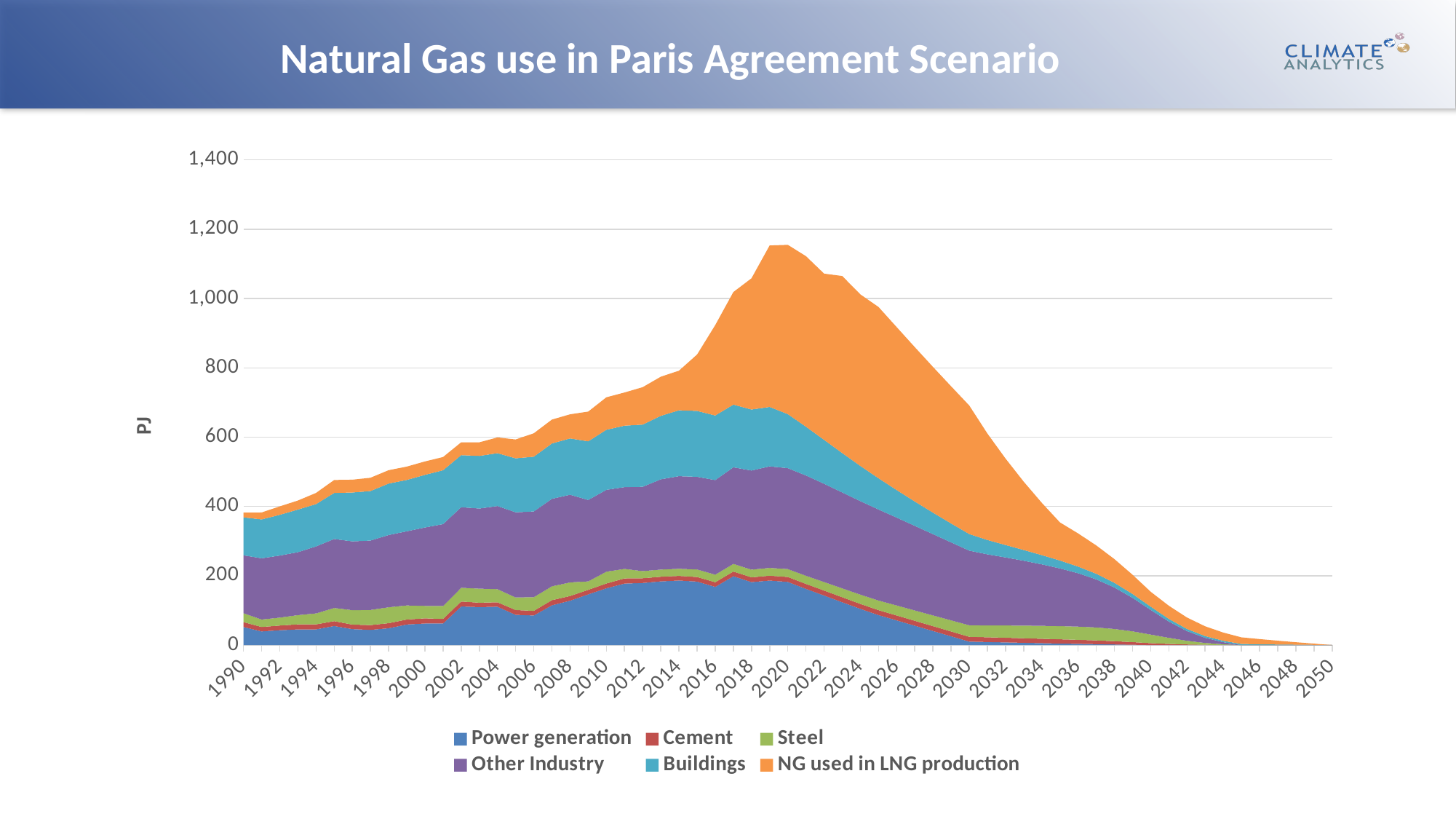
Which year has the larger total natural gas use, 1990 or 2020? 2020 How many series does the legend list? 6 Which series is plotted at the top of the stack? NG used in LNG production Does the total natural gas use rise or fall between 2020 and 2050? fall Is the total natural gas use in 2040 greater or less than 400? less How many year labels are shown on the x axis? 31 In which year does the total natural gas use reach its highest point? 2020 Is the total natural gas use in 2020 greater or less than 1,000? greater What kind of chart is shown on the slide? stacked area chart Is the total natural gas use in 2010 greater or less than 600? greater What is the title of the chart? Natural Gas use in Paris Agreement Scenario